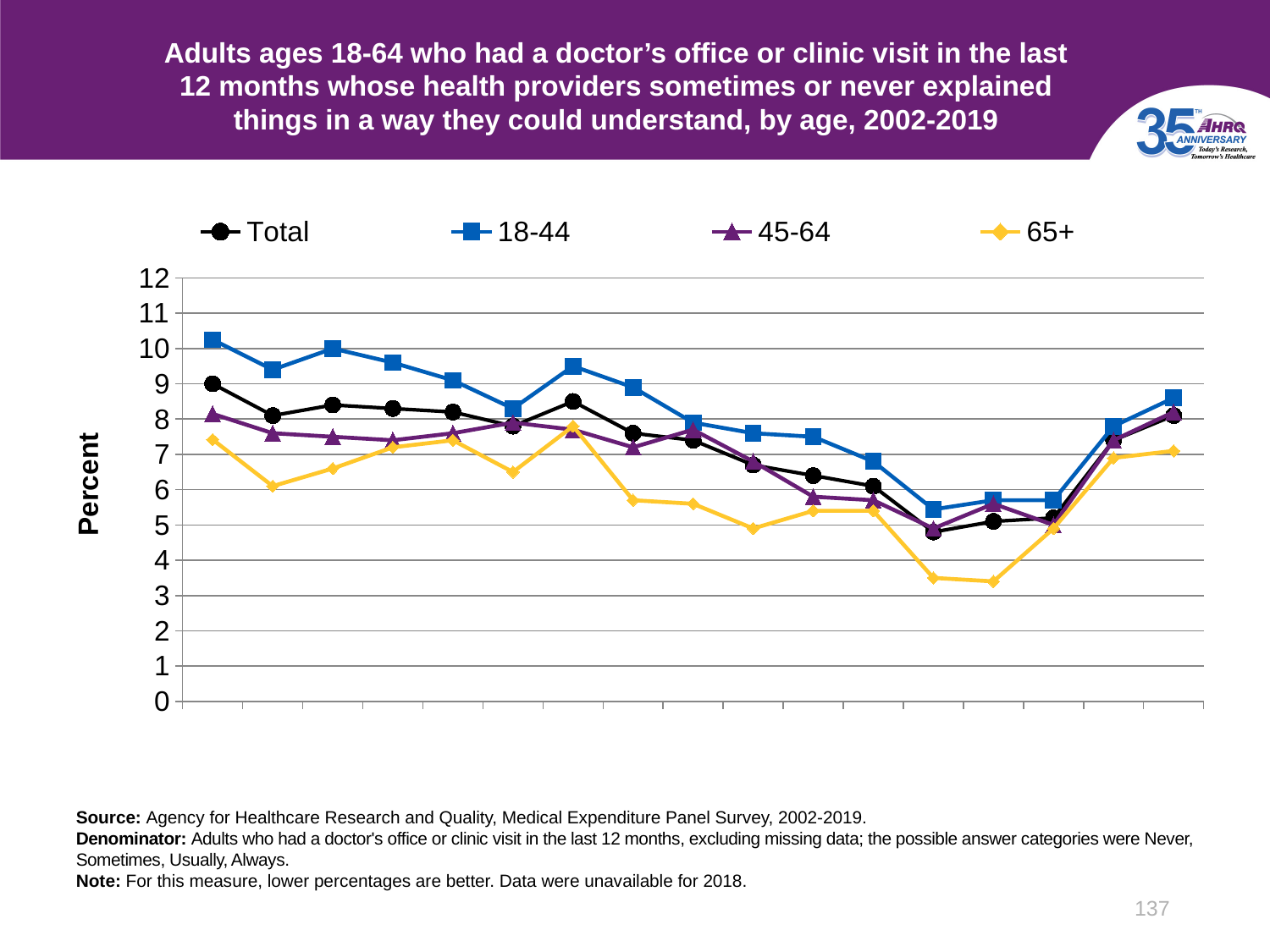
Which series has the lowest value at the first (leftmost) point? 65+ Which series has the highest value at the first (leftmost) point? 18-44 What are the series listed in the legend? Total, 18-44, 45-64, 65+ Is the lowest value of the 65+ series greater or less than 4? less At the leftmost point, is the value for 18-44 greater or less than 9? greater At the leftmost point, which is larger: the value for 45-64 or the value for 65+? 45-64 What is the label on the vertical axis? Percent What kind of chart is shown on the slide? Line chart At the leftmost point, is the value for Total greater or less than 8? greater How many series does the legend list? 4 How many data points are plotted for the Total series? 17